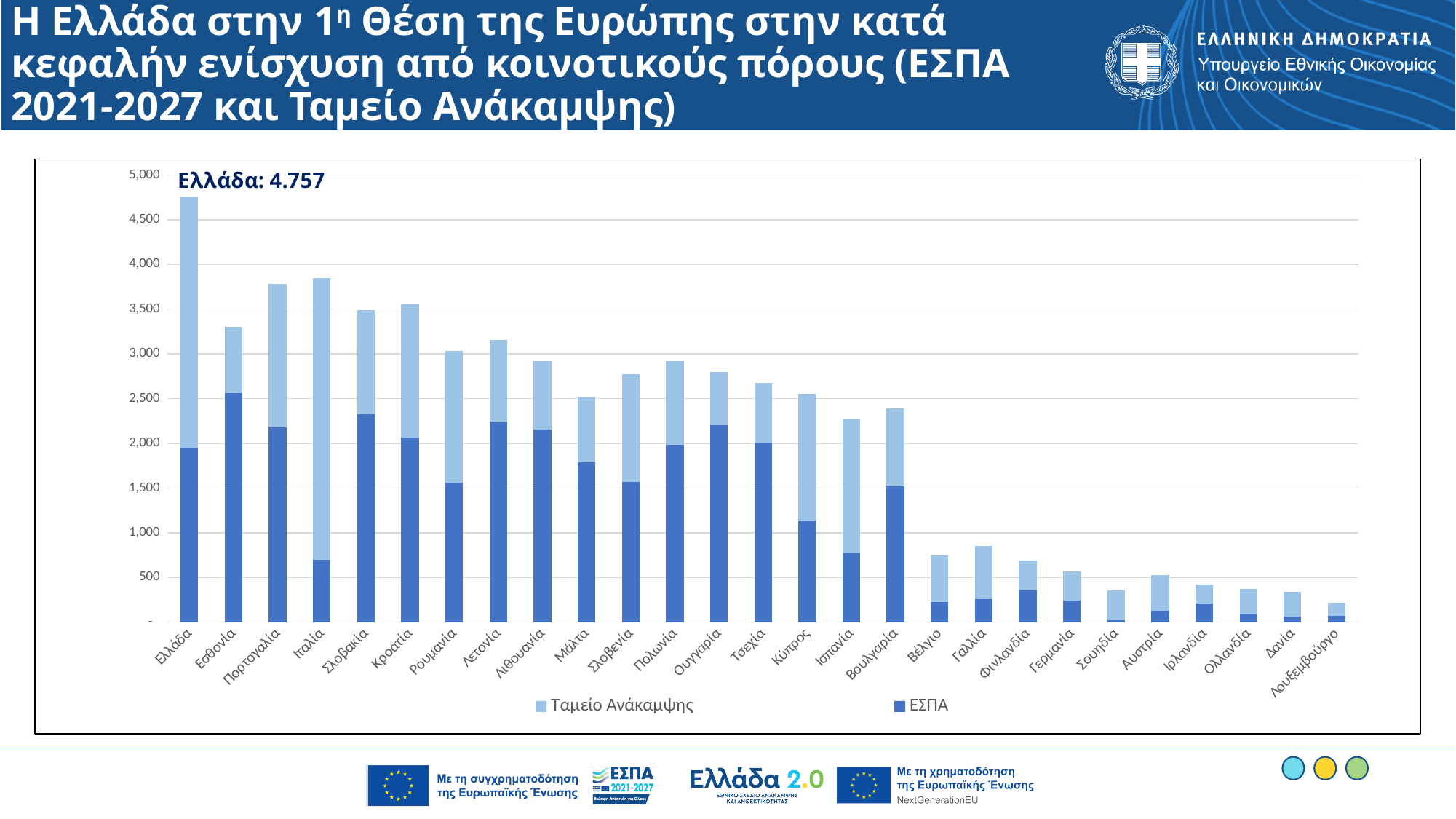
Is the total value for Γαλλία greater or less than 1,000? less Which country has the highest total bar? Ελλάδα Is the ΕΣΠΑ value for Ιταλία greater or less than 1,000? less Which two series are listed in the legend? Ταμείο Ανάκαμψης and ΕΣΠΑ Do the total bar values generally rise or fall from left to right along the x axis? fall What kind of chart is shown on the slide? Stacked bar chart Which has the larger total bar, Εσθονία or Πορτογαλία? Πορτογαλία What is the total value labelled for Ελλάδα? 4.757 How many series does the legend list? 2 How many countries are shown on the x axis? 27 Is the total value for Εσθονία greater or less than 3,000? greater Which country has the lowest total bar? Λουξεμβούργο